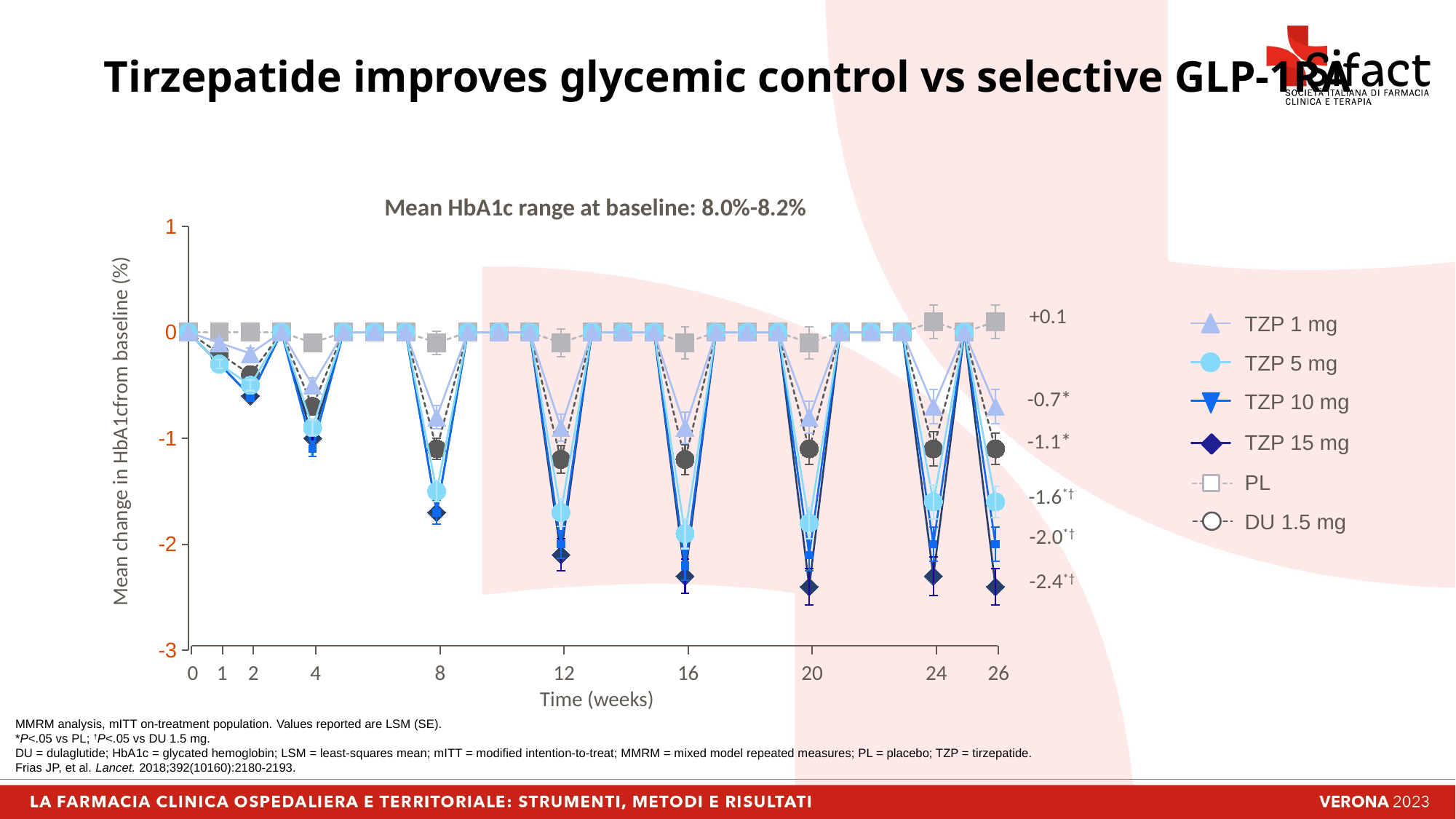
What is the mean change in HbA1c from baseline at week 26 for PL? +0.1 What is the mean change in HbA1c from baseline at week 26 for TZP 15 mg? -2.4 Which series shows the largest reduction in HbA1c at week 26? TZP 15 mg Which series has the highest (least negative) value at week 26? PL What is the mean change in HbA1c from baseline at week 26 for DU 1.5 mg? -1.1 At week 26, which has a larger HbA1c reduction: TZP 5 mg or DU 1.5 mg? TZP 5 mg What is the mean HbA1c range at baseline stated in the chart title? 8.0%-8.2% What is the difference between the week 26 values for TZP 15 mg and DU 1.5 mg? 1.3 What type of chart is shown on the slide? line chart What is the label of the x axis? Time (weeks) What is the mean change in HbA1c from baseline at week 26 for TZP 10 mg? -2.0 How many series does the legend list? 6